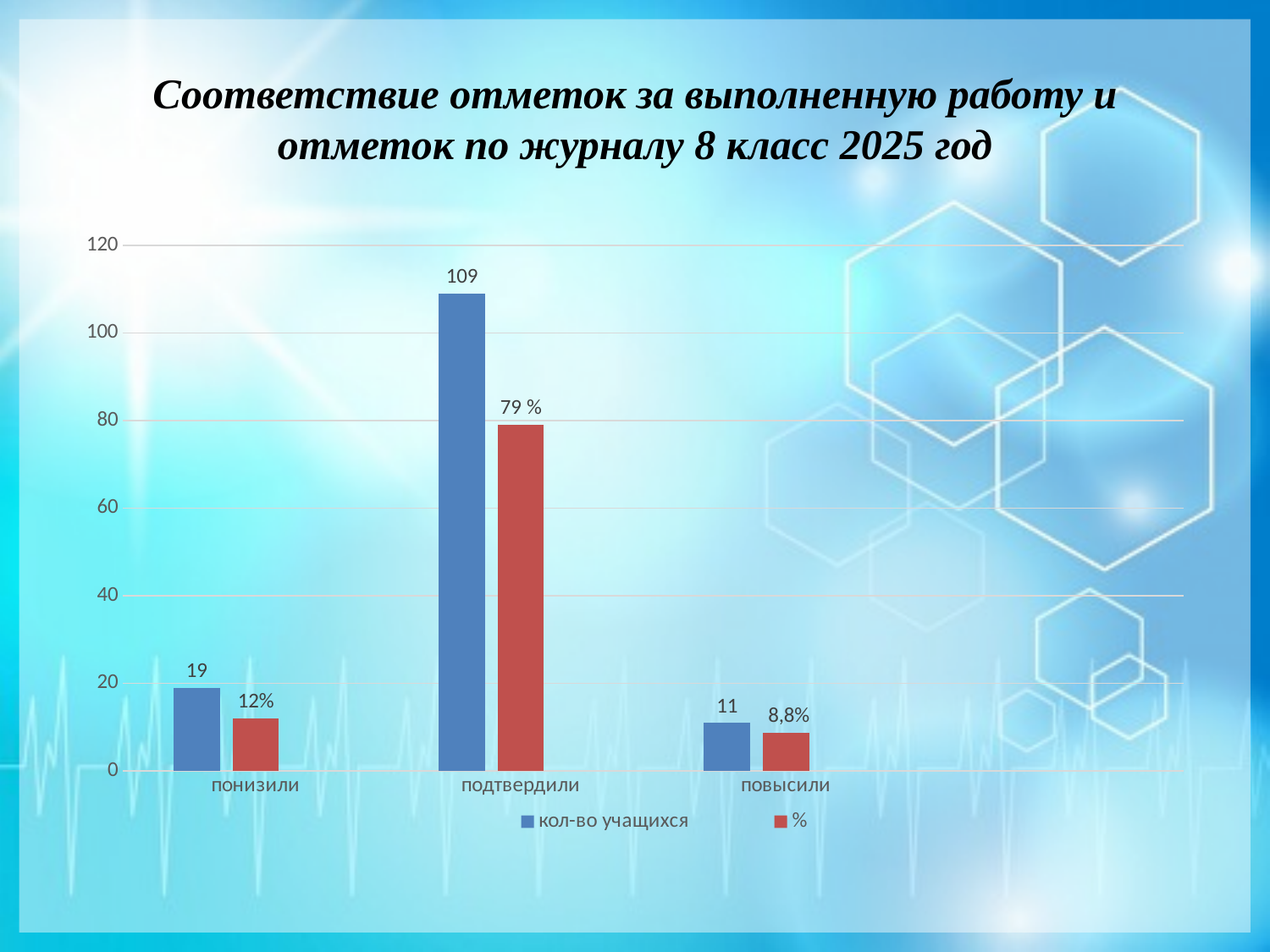
How many categories are shown on the x axis? 3 What is the % value for понизили? 12% What type of chart is shown on the slide? bar chart What is the difference in кол-во учащихся between подтвердили and понизили? 90 Which category has the lowest value for кол-во учащихся? повысили Which is larger, the кол-во учащихся for понизили or for повысили? понизили What is the % value for повысили? 8,8% How many series does the legend list? 2 What is the value of кол-во учащихся for подтвердили? 109 Which category has the highest value for кол-во учащихся? подтвердили Is the кол-во учащихся value for подтвердили greater or less than 100? greater What is the value of кол-во учащихся for повысили? 11